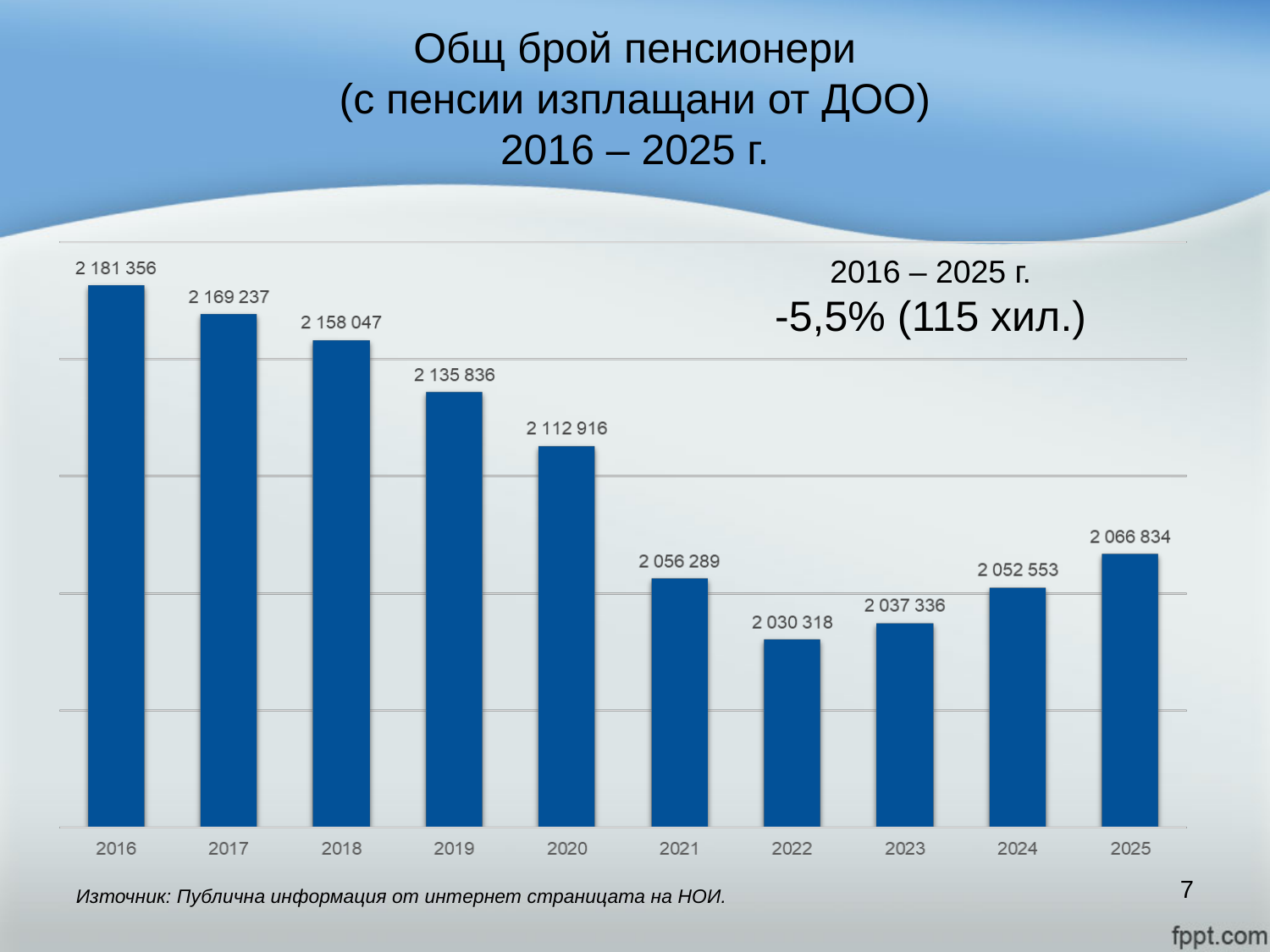
What is the difference between the values for 2025 and 2024? 14 281 What kind of chart is this? bar chart What is the value for 2022? 2 030 318 What is the difference between the values for 2016 and 2025? 114 522 What is the value for 2016? 2 181 356 What is the value for 2020? 2 112 916 Which year has the lowest value? 2022 What is the value for 2025? 2 066 834 Which year has the highest value? 2016 Which is larger, the value for 2019 or the value for 2021? 2019 How many years are shown on the x axis? 10 Do the values rise or fall from 2016 to 2022? fall